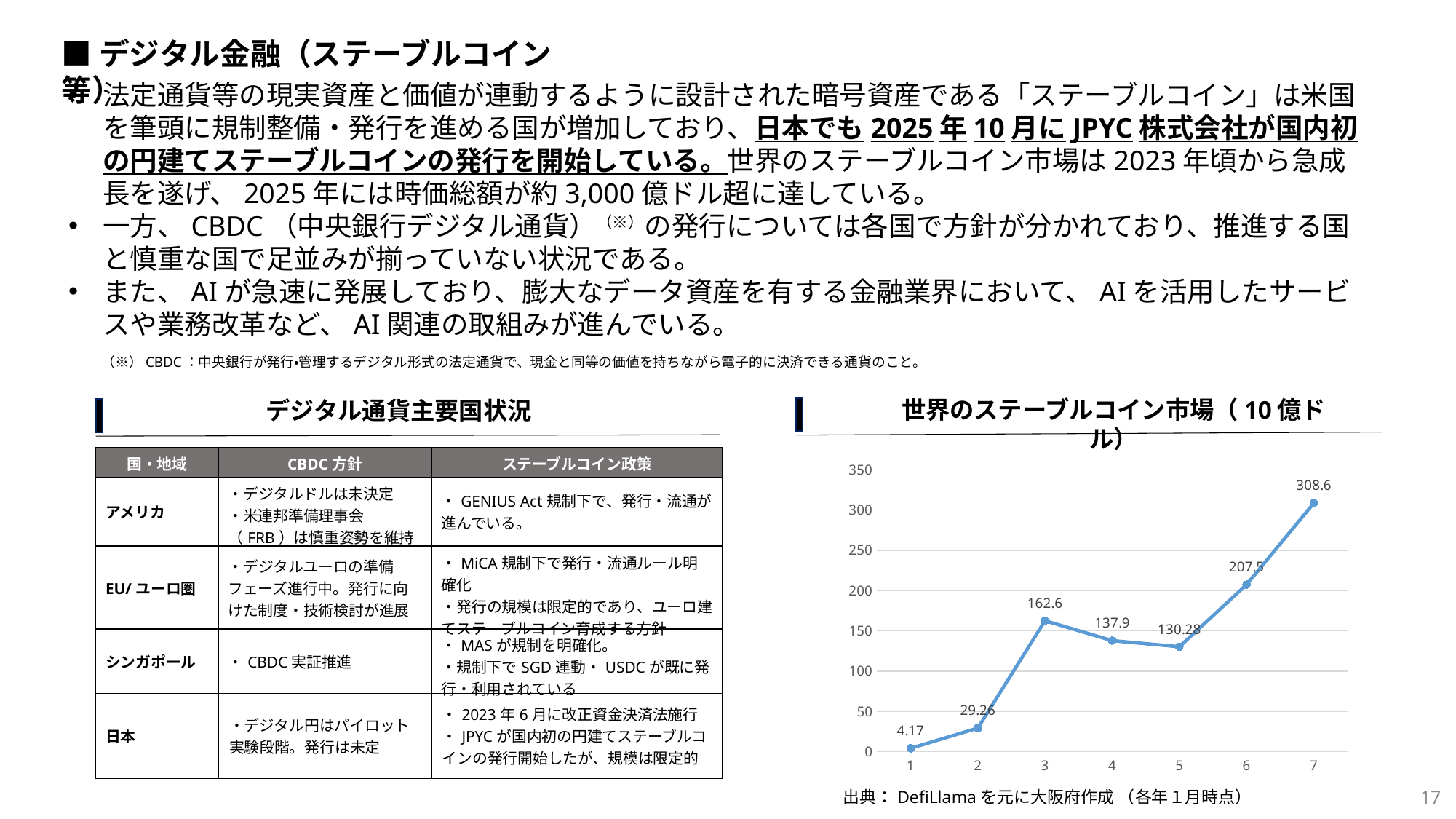
In the chart 世界のステーブルコイン市場（10億ドル）, what is the value at x-axis point 5? 130.28 In the chart 世界のステーブルコイン市場（10億ドル）, what is the difference between the values at points 3 and 4? 24.7 In the chart 世界のステーブルコイン市場（10億ドル）, which x-axis point has the lowest value? 1 In the chart 世界のステーブルコイン市場（10億ドル）, which x-axis point has the highest value? 7 In the chart 世界のステーブルコイン市場（10億ドル）, what is the difference between the values at points 7 and 6? 101.1 In the chart 世界のステーブルコイン市場（10億ドル）, what is the value at x-axis point 7? 308.6 In the chart 世界のステーブルコイン市場（10億ドル）, is the value at point 6 greater or less than 200? greater In the chart 世界のステーブルコイン市場（10億ドル）, what is the value at x-axis point 3? 162.6 In the chart 世界のステーブルコイン市場（10億ドル）, what is the value at x-axis point 1? 4.17 In the chart 世界のステーブルコイン市場（10億ドル）, which is larger, the value at point 3 or the value at point 5? point 3 What type of chart is shown under the title 世界のステーブルコイン市場（10億ドル）? line chart How many data points are plotted in the chart 世界のステーブルコイン市場（10億ドル）? 7